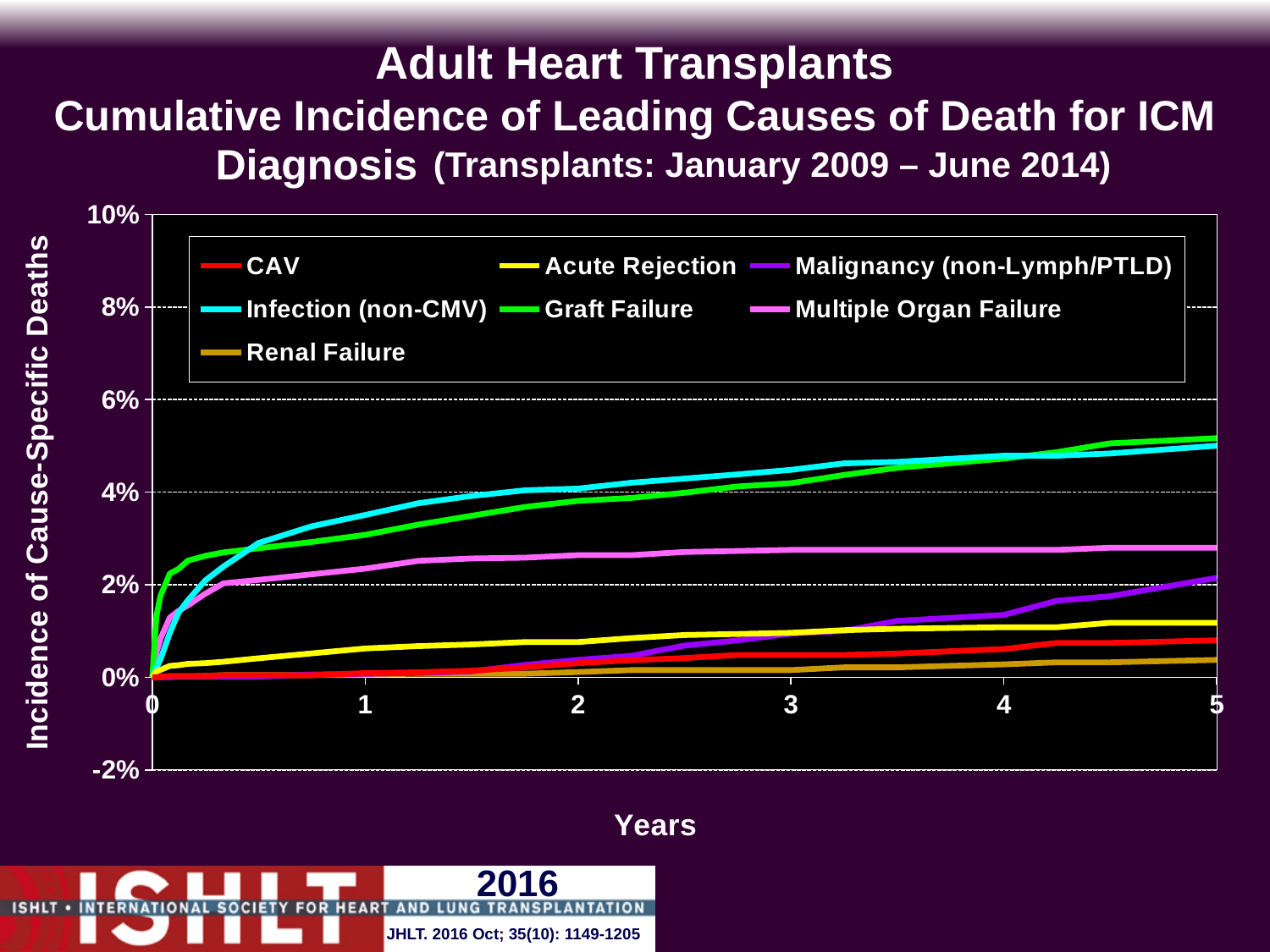
What transplant period does the chart title cover? January 2009 – June 2014 What is the label of the y axis? Incidence of Cause-Specific Deaths What kind of chart is shown on the slide? Line chart Does the Multiple Organ Failure line rise or fall from 0 to 5 years? Rise Is the value for Infection (non-CMV) at 5 years greater or less than 6%? less At 3 years, which is larger: Infection (non-CMV) or Malignancy (non-Lymph/PTLD)? Infection (non-CMV) Is the value for Multiple Organ Failure at 5 years greater or less than 2%? greater Is the value for Graft Failure at 5 years greater or less than 4%? greater How many series does the legend list? 7 At 5 years, which is larger: Multiple Organ Failure or Acute Rejection? Multiple Organ Failure